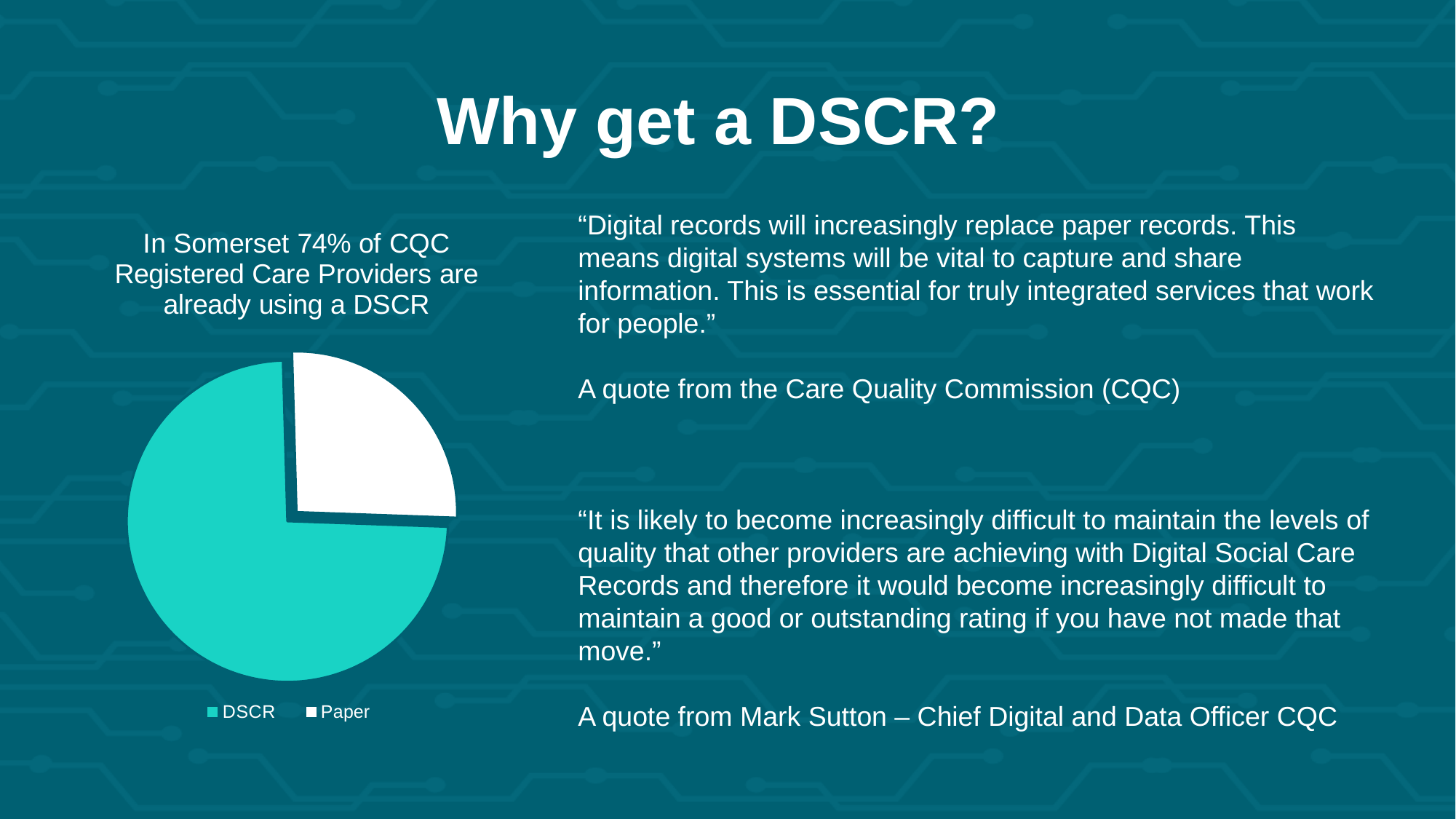
What share of the pie chart does the DSCR slice represent? 74% What share of the pie chart does the Paper slice represent? 26% How many slices does the pie chart have? 2 Is the share for Paper greater or less than 50%? less Which category has the smallest slice of the pie chart? Paper Is the share for DSCR greater or less than 50%? greater What colour is the DSCR slice in the pie chart? Teal Which slice is larger in the pie chart, DSCR or Paper? DSCR How many entries does the pie chart's legend list? 2 What kind of chart is shown on the slide? Pie chart Which category has the largest slice of the pie chart? DSCR What is the title of the pie chart? In Somerset 74% of CQC Registered Care Providers are already using a DSCR